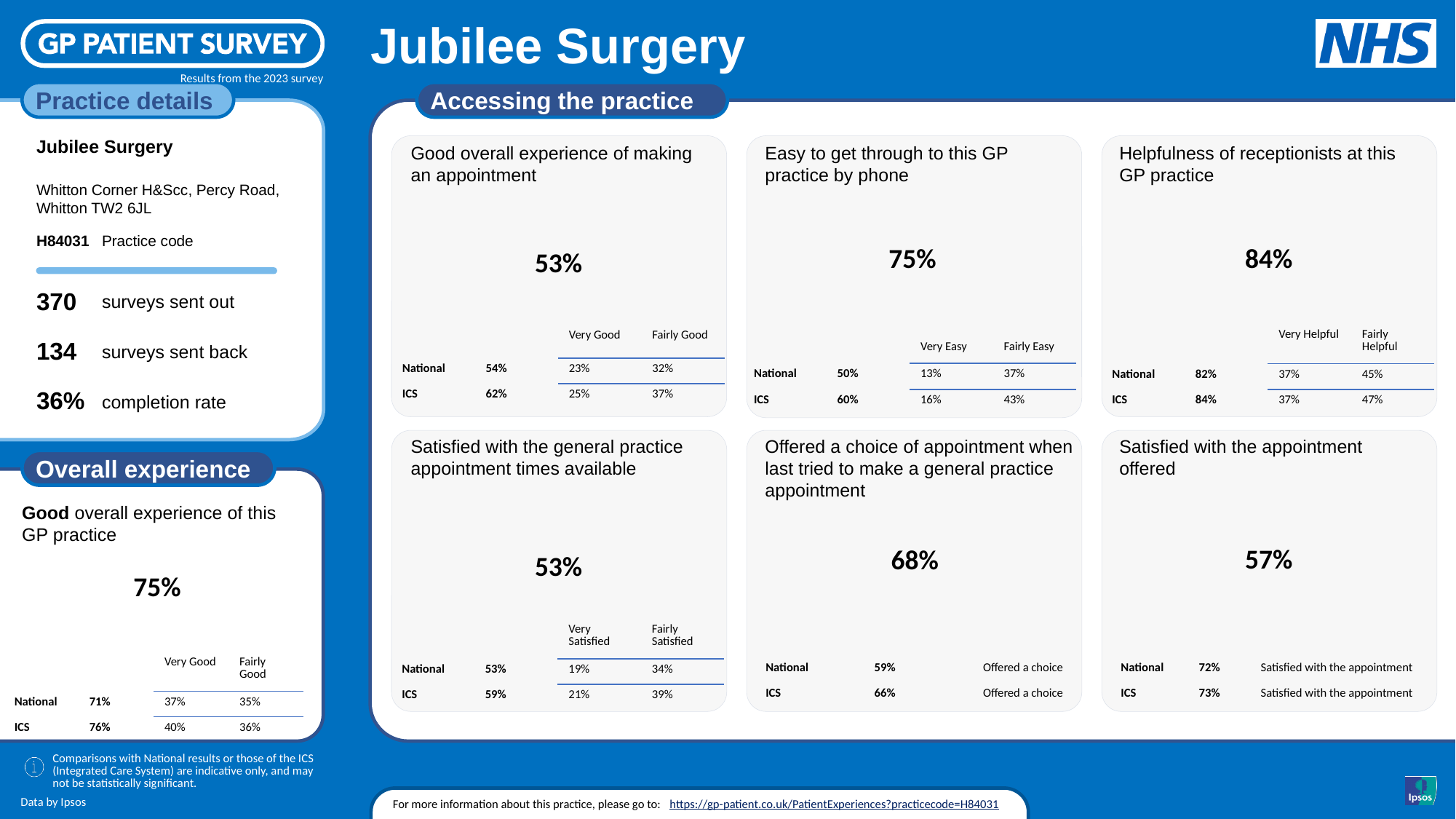
On the 'Easy to get through to this GP practice by phone' chart, what is the National value? 50% On the 'Satisfied with the general practice appointment times available' chart, what is the National 'Very Satisfied' value? 19% On the 'Satisfied with the appointment offered' chart, what is the difference between the National value and the practice's headline value? 15% On the 'Good overall experience of this GP practice' chart, what is the ICS 'Very Good' value? 40% How many charts are shown in the 'Accessing the practice' section? 6 On the 'Helpfulness of receptionists at this GP practice' chart, what is the ICS 'Fairly Helpful' value? 47% On the 'Easy to get through to this GP practice by phone' chart, what is the difference between the practice's headline value and the ICS value? 15% On the 'Good overall experience of this GP practice' chart in the Overall experience section, which is larger: the National value or the ICS value? ICS On the 'Offered a choice of appointment when last tried to make a general practice appointment' chart, what is the ICS value? 66% On the 'Good overall experience of making an appointment' chart, what is the headline percentage for the practice? 53% On the 'Helpfulness of receptionists at this GP practice' chart, what are the two response categories listed in the table? Very Helpful, Fairly Helpful Across the six charts in the 'Accessing the practice' section, which chart has the highest headline percentage? Helpfulness of receptionists at this GP practice